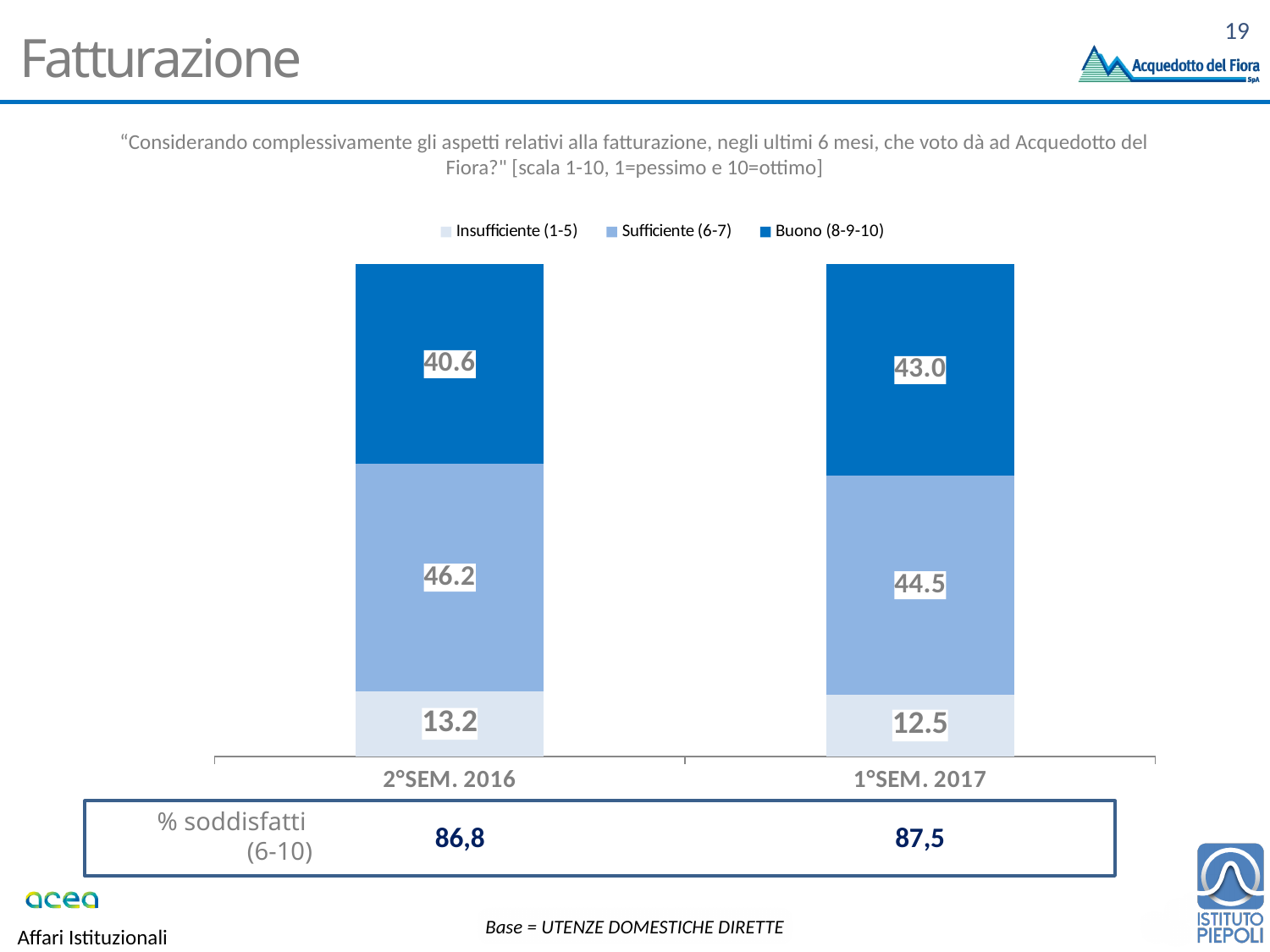
What is the difference between the Buono (8-9-10) values for 1°SEM. 2017 and 2°SEM. 2016? 2.4 What is the total of the stacked bar for 2°SEM. 2016? 100.0 How many categories are shown on the x axis? 2 Which category has the higher value for Buono (8-9-10)? 1°SEM. 2017 Which category has the lower value for Insufficiente (1-5)? 1°SEM. 2017 What kind of chart is shown on the slide? Stacked bar chart What is the value of Insufficiente (1-5) for 2°SEM. 2016? 13.2 What is the value of Buono (8-9-10) for 1°SEM. 2017? 43.0 What is the value of Sufficiente (6-7) for 1°SEM. 2017? 44.5 How many series does the legend list? 3 What is the value of Sufficiente (6-7) for 2°SEM. 2016? 46.2 Is the Sufficiente (6-7) value larger for 2°SEM. 2016 or for 1°SEM. 2017? 2°SEM. 2016